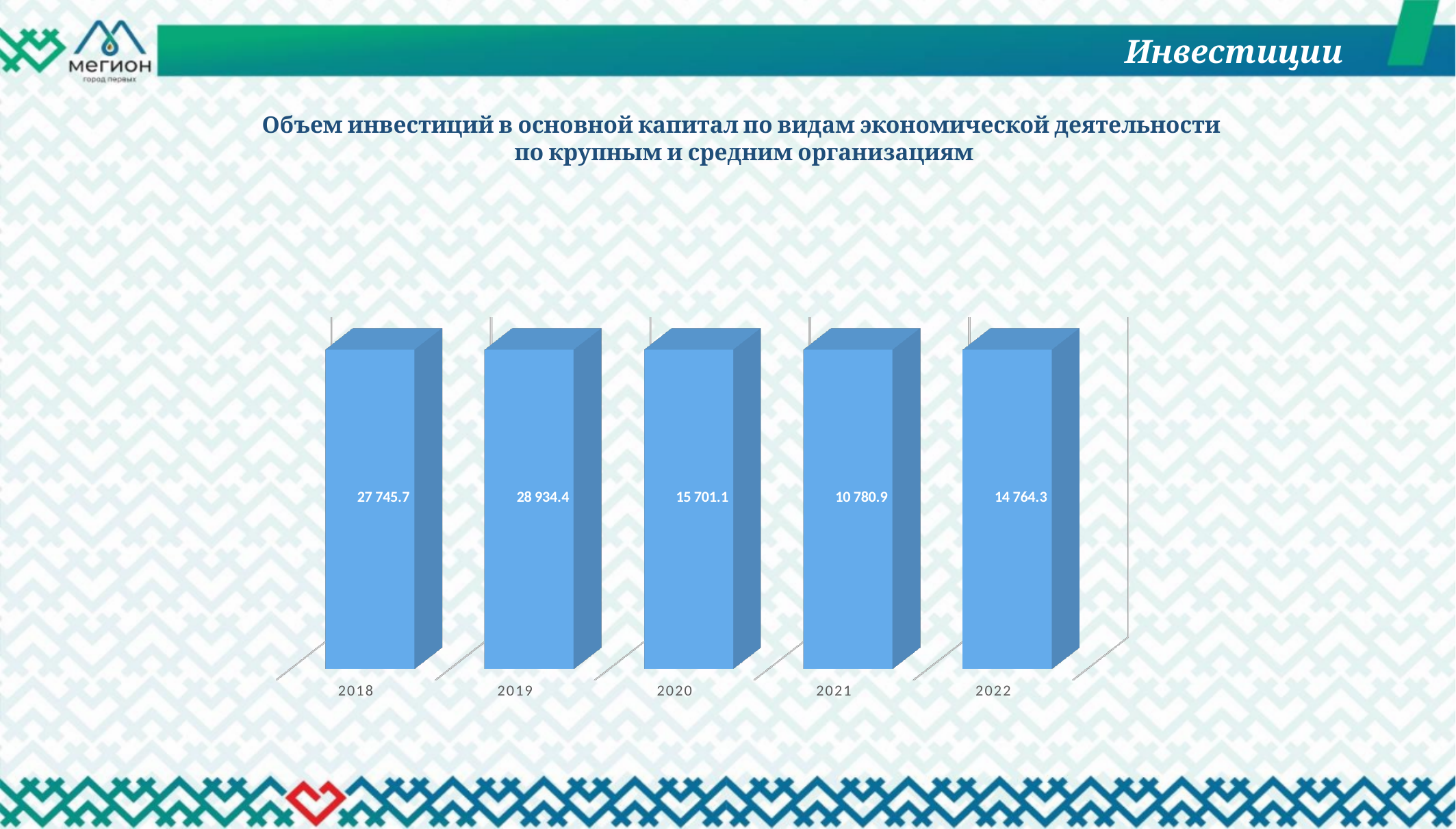
Which year has the lowest value according to the data labels? 2021 What is the difference between the values for 2020 and 2021? 4 920.2 What is the value shown for 2021? 10 780.9 Which year has the highest value according to the data labels? 2019 How many years are shown on the x axis? 5 What is the title of the chart? Объем инвестиций в основной капитал по видам экономической деятельности по крупным и средним организациям What is the value shown for 2018? 27 745.7 Which is larger, the value for 2020 or the value for 2022? 2020 What is the value shown for 2022? 14 764.3 What kind of chart is shown on the slide? Bar chart Do the values rise or fall from 2019 to 2021? Fall What is the difference between the values for 2019 and 2018? 1 188.7